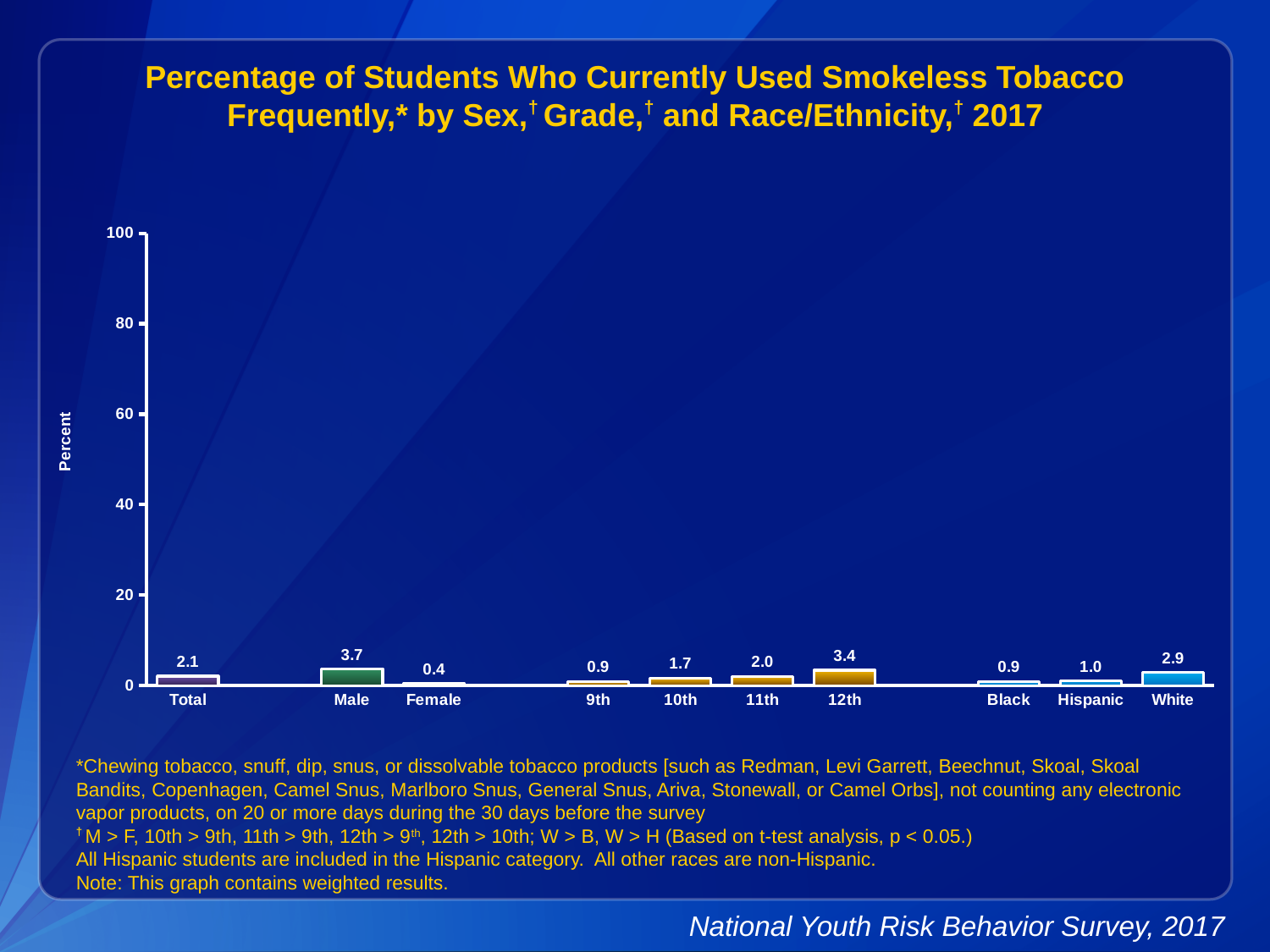
What is the value for Total? 2.1 Do the values rise or fall from 9th grade to 12th grade? rise What is the value for Female? 0.4 What is the value for Male? 3.7 Which category has the lowest value? Female What is the difference between the values for Male and Female? 3.3 Which category has the highest value? Male How many categories are shown on the x axis? 10 What kind of chart is this? bar chart What is the value for 12th grade? 3.4 Which is larger, the value for White or the value for Hispanic? White Is the value for 12th grade greater or less than 20? less